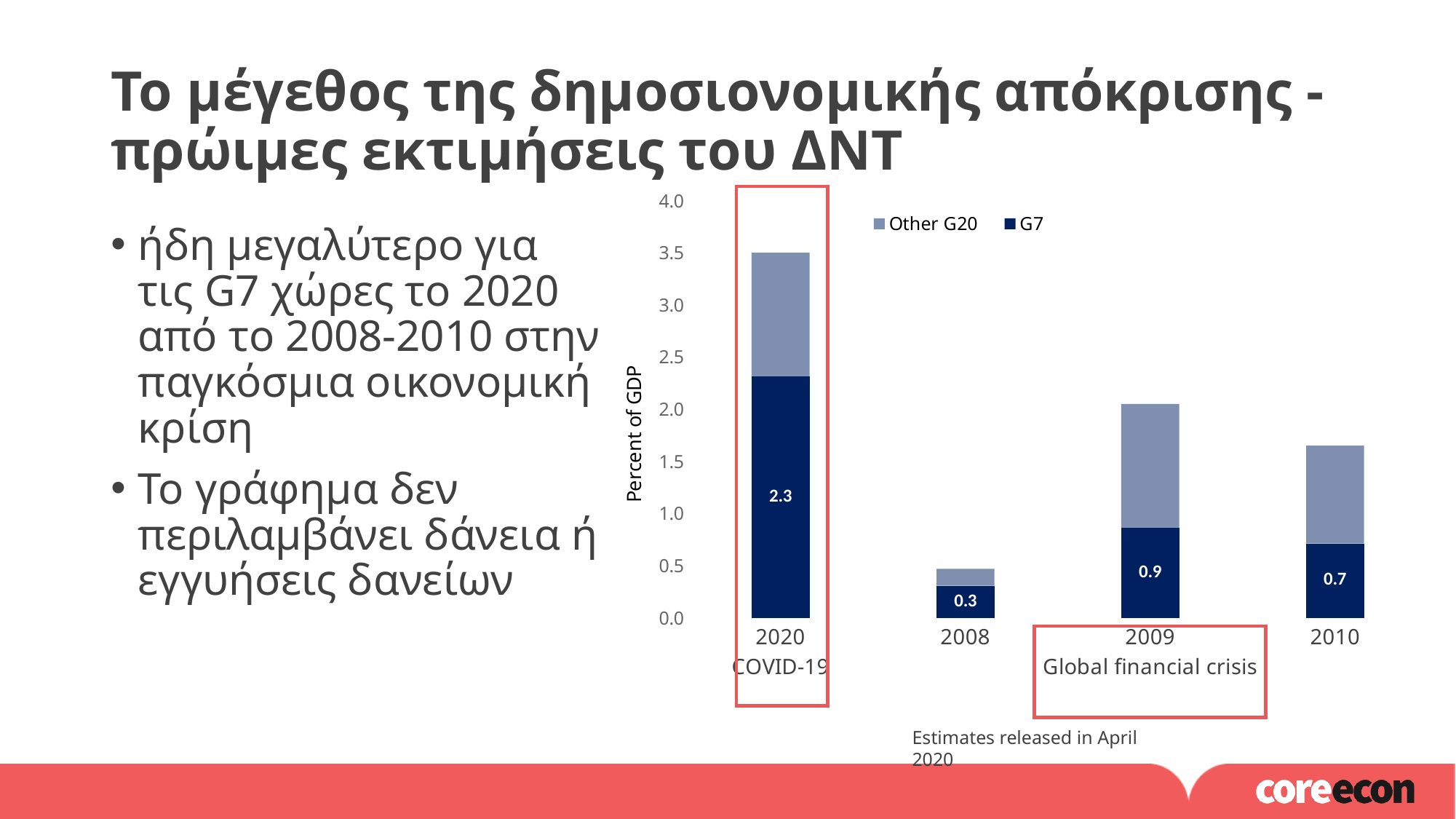
Which year has the lowest G7 value? 2008 What is the G7 value for 2020? 2.3 How many series does the legend list? 2 Is the total height of the 2020 bar greater or less than 3.0? greater What is the G7 value for 2008? 0.3 Is the total height of the 2008 bar greater or less than 1.0? less What is the G7 value for 2009? 0.9 What is the G7 value for 2010? 0.7 What is the difference between the G7 value for 2020 and the G7 value for 2009? 1.4 Which year has the highest G7 value? 2020 What kind of chart is shown on the slide? Stacked bar chart Which year has the larger G7 value, 2009 or 2010? 2009